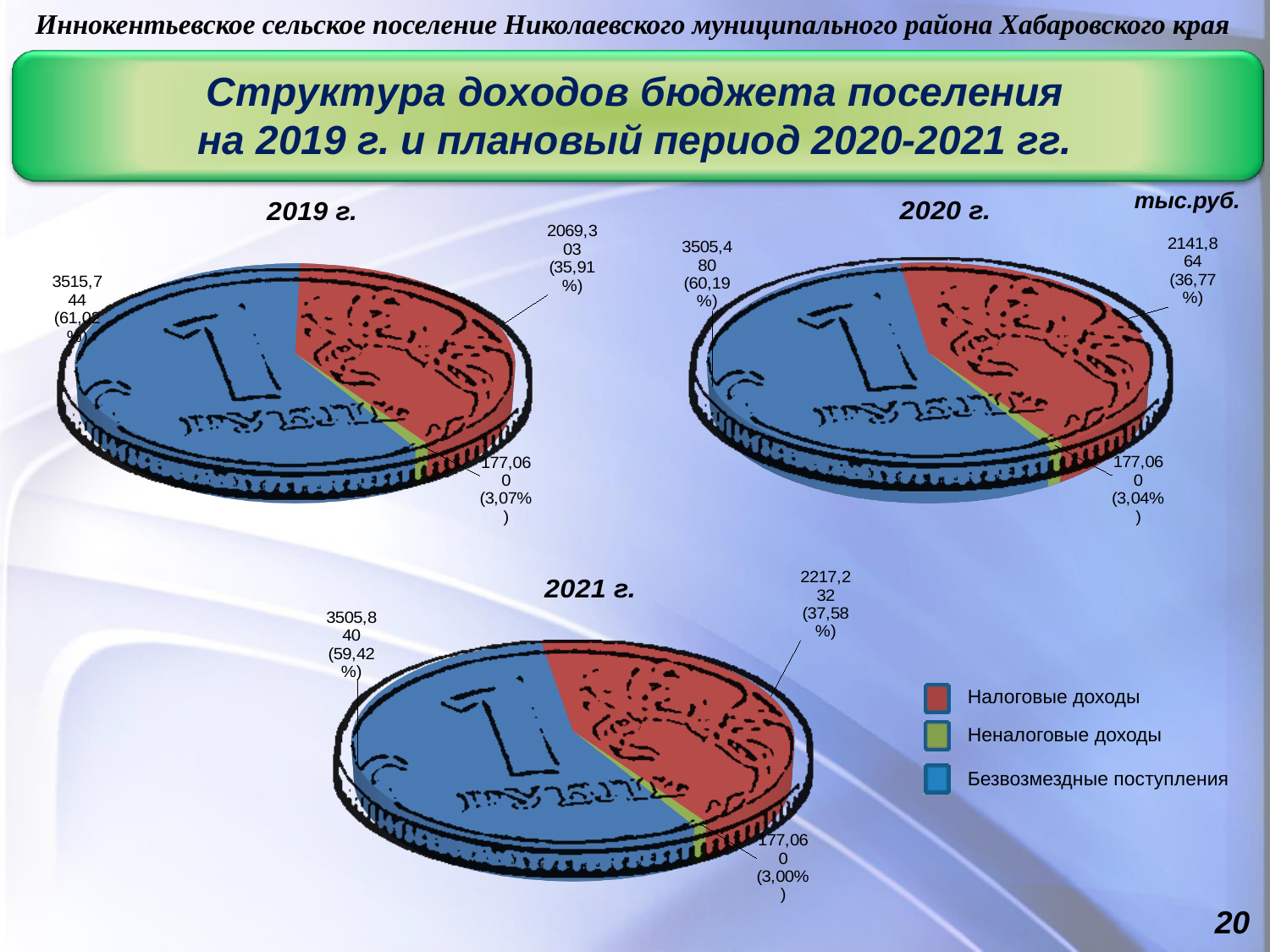
In the 2019 г. chart, what is the value for Налоговые доходы? 2069,303 (35,91%) In the 2019 г. chart, what is the value for Неналоговые доходы? 177,060 (3,07%) What kind of chart is used for the 2019 г. data? pie chart In the 2019 г. chart, which is larger: Налоговые доходы or Неналоговые доходы? Налоговые доходы Which colour represents Безвозмездные поступления in the legend? blue In the 2020 г. chart, which category has the smallest slice? Неналоговые доходы In the 2021 г. chart, which category has the largest slice? Безвозмездные поступления In the 2021 г. chart, what is the value for Налоговые доходы? 2217,232 (37,58%) In the 2020 г. chart, what share of the pie is Налоговые доходы? 36,77% In the 2021 г. chart, what share of the pie is Неналоговые доходы? 3,00% How many categories does the legend list? 3 In the 2020 г. chart, what is the value for Безвозмездные поступления? 3505,480 (60,19%)